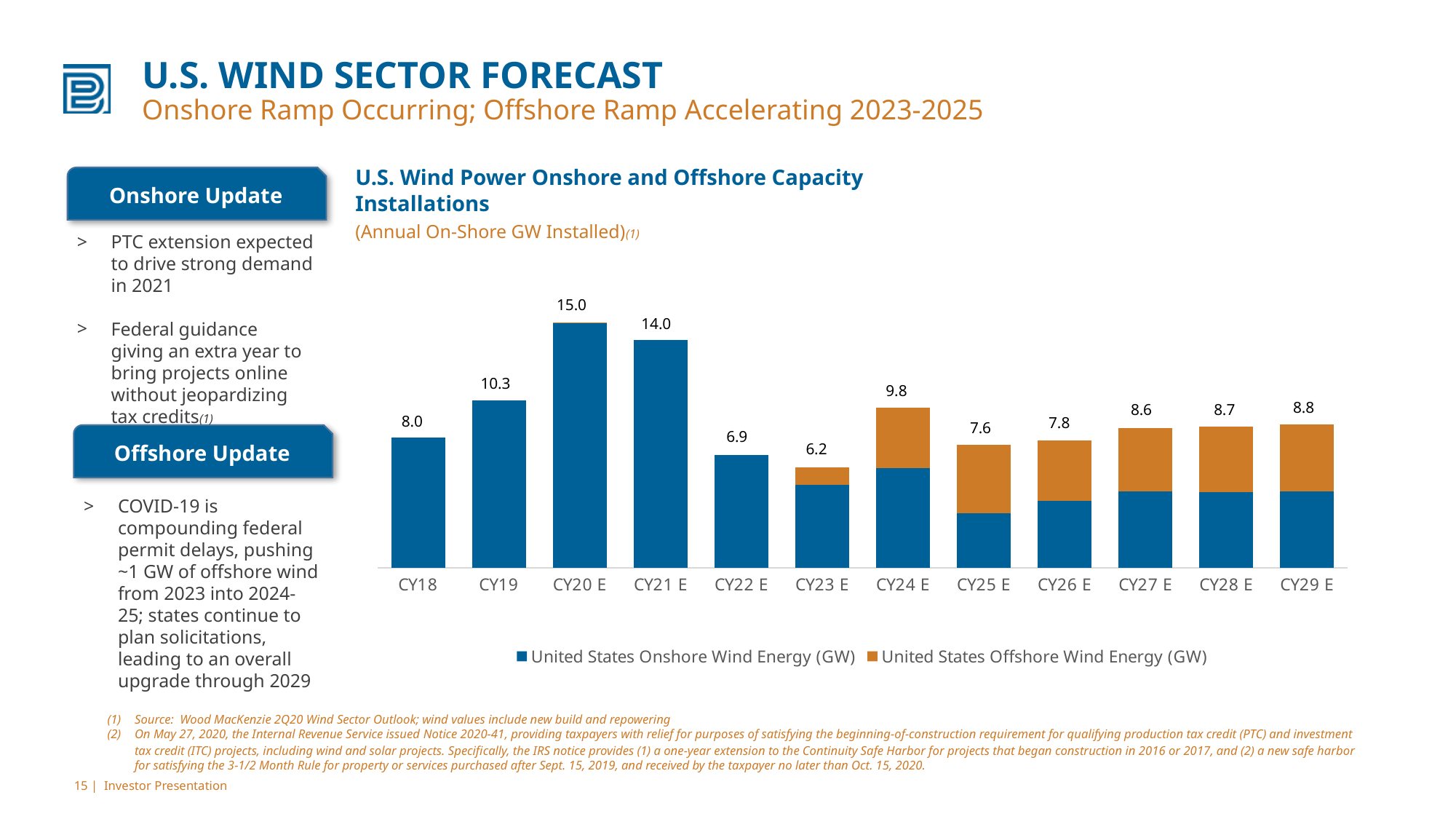
Do the totals rise or fall from CY25 E to CY29 E? Rise Which is larger, the total for CY22 E or the total for CY25 E? CY25 E What is the total value labeled for CY24 E? 9.8 What kind of chart is shown? Stacked bar chart What is the value shown for CY18? 8.0 How many series does the legend list? 2 Which year has the lowest total capacity installed? CY23 E What is the difference between the totals for CY20 E and CY21 E? 1.0 What is the total capacity installed shown for CY20 E? 15.0 How many years are shown on the x axis? 12 Which year has the highest total capacity installed? CY20 E What is the difference between the totals for CY19 and CY18? 2.3